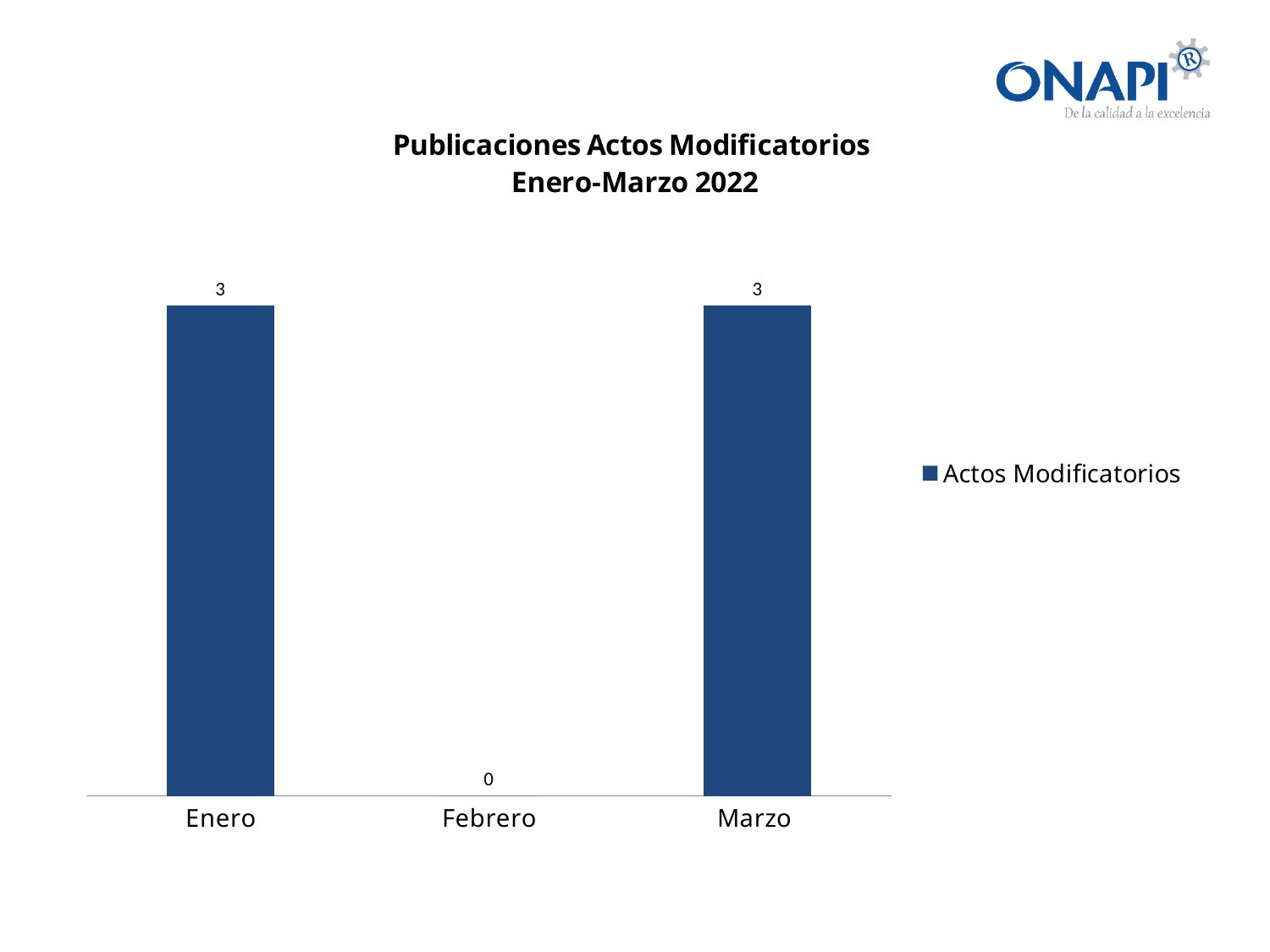
What is the value for Febrero? 0 Which is larger, the value for Marzo or the value for Febrero? Marzo What is the total of the values for Enero, Febrero and Marzo? 6 What is the title of the chart? Publicaciones Actos Modificatorios Enero-Marzo 2022 What is the value for Enero? 3 What is the difference between the values for Enero and Febrero? 3 What series name is shown in the legend? Actos Modificatorios What kind of chart is shown? bar chart What is the value for Marzo? 3 How many months are shown on the x axis? 3 Which month has the lowest value? Febrero How many series does the legend list? 1